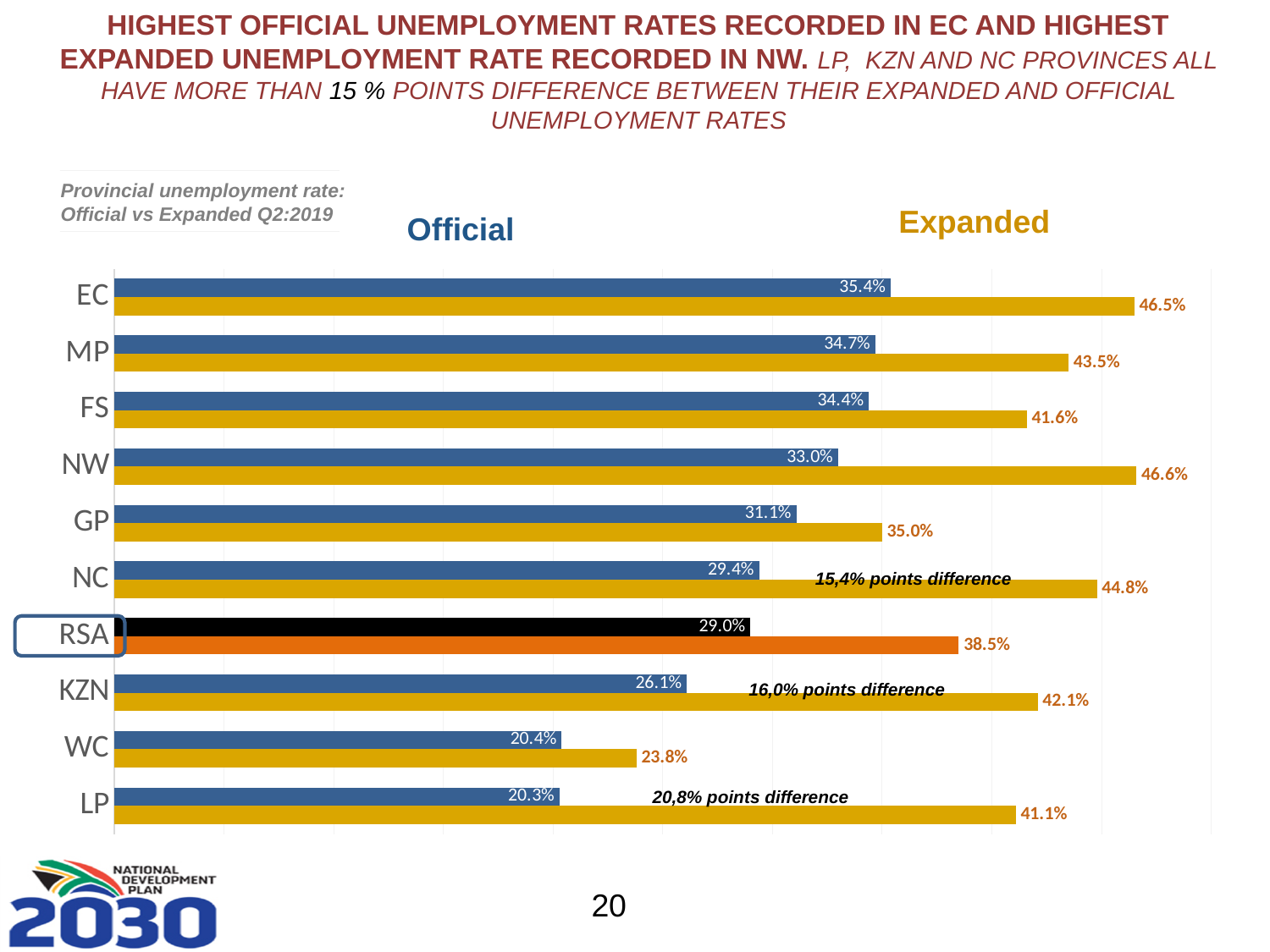
What is the official unemployment rate for EC? 35.4% What is the expanded unemployment rate for NW? 46.6% Which category has the lowest expanded unemployment rate? WC What is the difference between the expanded and official unemployment rates for EC? 11.1 percentage points How many categories (provinces plus RSA) are shown on the chart? 10 How many series does the chart show? 2 Which province has the highest official unemployment rate? EC What is the official unemployment rate for KZN? 26.1% What is the difference between the expanded and official unemployment rates for LP? 20.8 percentage points What kind of chart is shown on the slide? Bar chart Which is larger, the expanded unemployment rate for GP or for NC? NC What is the expanded unemployment rate for RSA? 38.5%